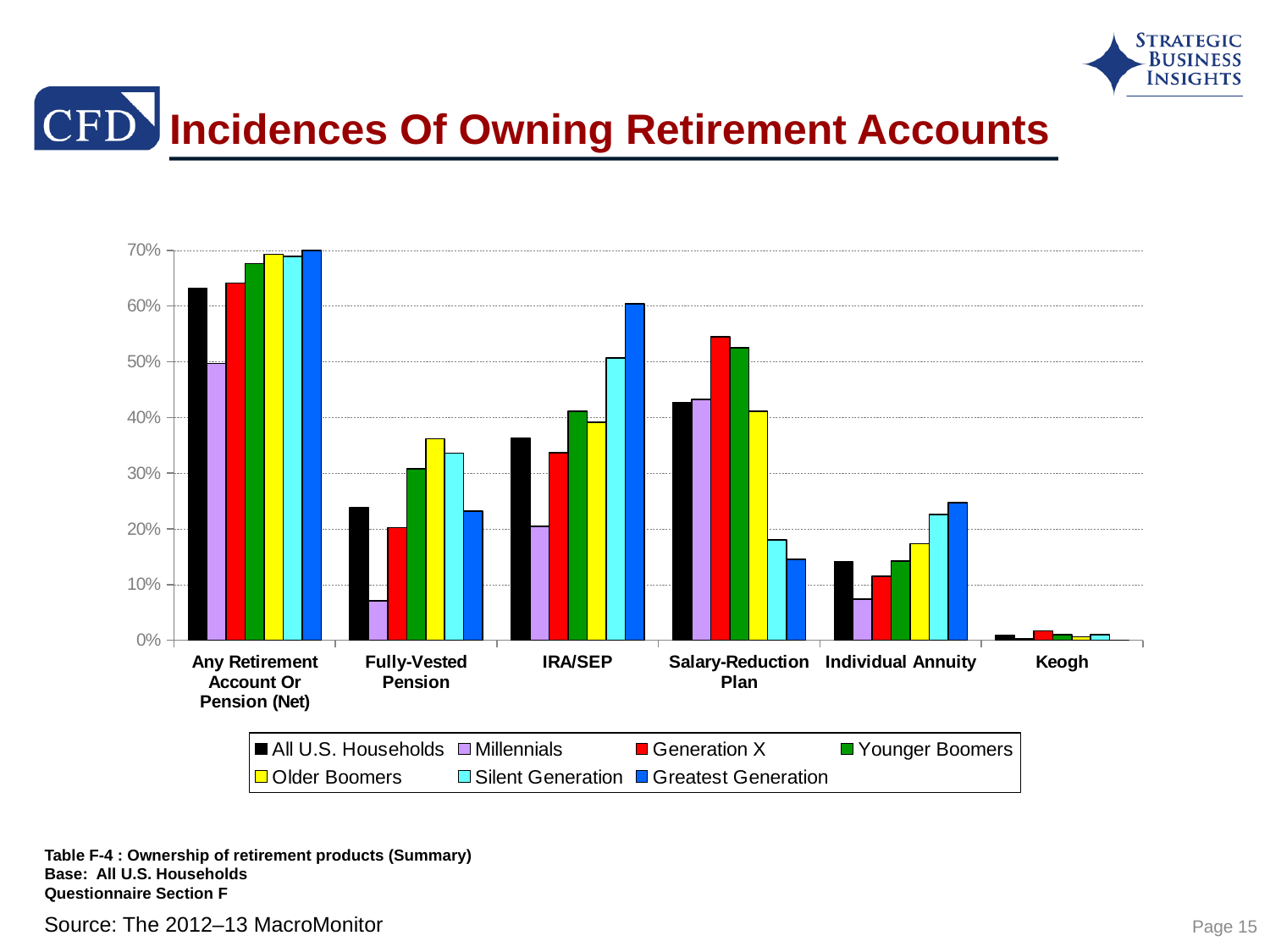
Is the value for Greatest Generation under Salary-Reduction Plan greater or less than 20%? less For Salary-Reduction Plan, which is larger: Generation X or Greatest Generation? Generation X What kind of chart is shown on the slide? bar chart How many retirement account categories are shown on the x axis? 6 For IRA/SEP, which generation has the highest value? Greatest Generation Is the value for Millennials under Any Retirement Account Or Pension (Net) greater or less than 60%? less Is the value for Greatest Generation under IRA/SEP greater or less than 50%? greater How many series does the legend list? 7 For Fully-Vested Pension, which generation has the lowest value? Millennials What is the title of the chart on the slide? Incidences Of Owning Retirement Accounts For Individual Annuity, which generation has the highest value? Greatest Generation